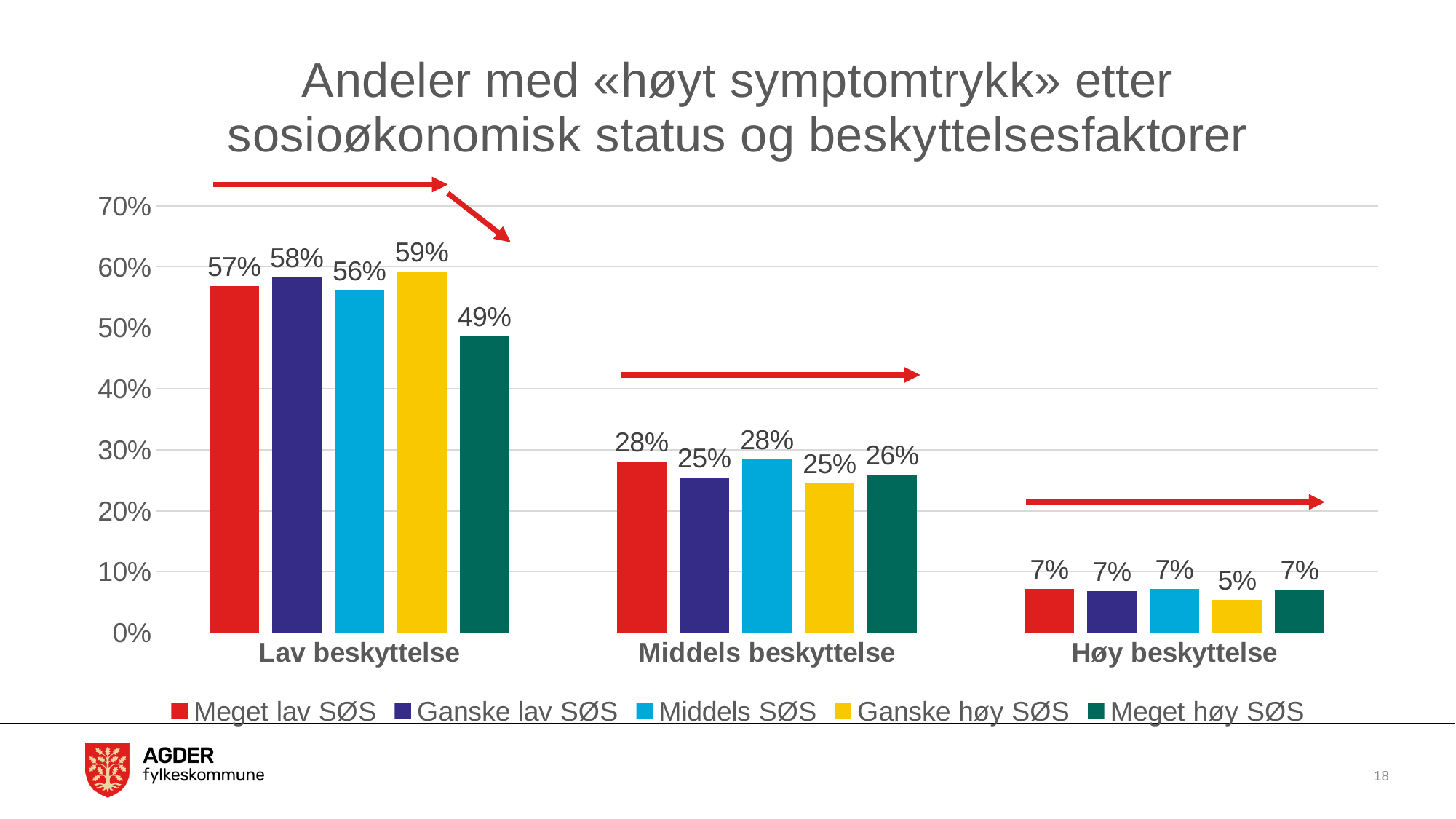
What is the value for Ganske høy SØS in the Høy beskyttelse group? 5% What is the difference between Ganske høy SØS and Meget høy SØS in the Lav beskyttelse group? 10% How many series does the legend list? 5 What is the value for Middels SØS in the Middels beskyttelse group? 28% What is the value for Meget lav SØS in the Lav beskyttelse group? 57% Which is larger in the Middels beskyttelse group: Meget lav SØS or Ganske lav SØS? Meget lav SØS What kind of chart is shown on the slide? Bar chart How many categories are shown on the x axis? 3 Do the values for Meget lav SØS rise or fall from Lav beskyttelse to Høy beskyttelse? Fall What is the value for Meget høy SØS in the Lav beskyttelse group? 49% Which series has the lowest value in the Høy beskyttelse group? Ganske høy SØS Which series has the highest value in the Lav beskyttelse group? Ganske høy SØS